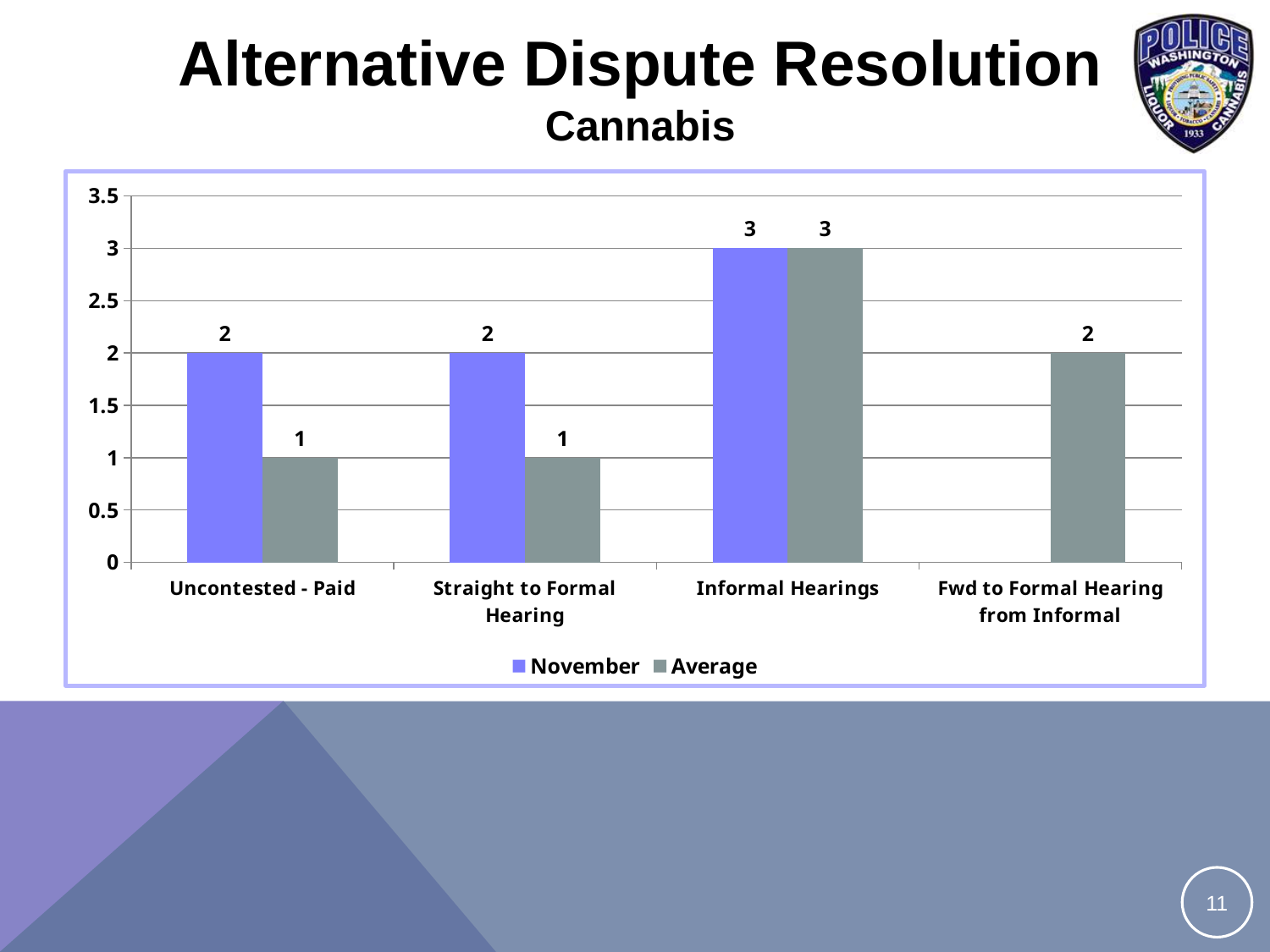
What is the Average value for Straight to Formal Hearing? 1 How many categories are shown on the x axis? 4 Which category has the highest Average value? Informal Hearings Which series is shown in purple? November What is the November value for Uncontested - Paid? 2 What is the November value for Informal Hearings? 3 Which is larger for Straight to Formal Hearing, the November value or the Average value? November What is the Average value for Fwd to Formal Hearing from Informal? 2 How many series does the legend list? 2 Which category has the highest November value? Informal Hearings What kind of chart is shown on the slide? Bar chart What is the difference between the November and Average values for Uncontested - Paid? 1